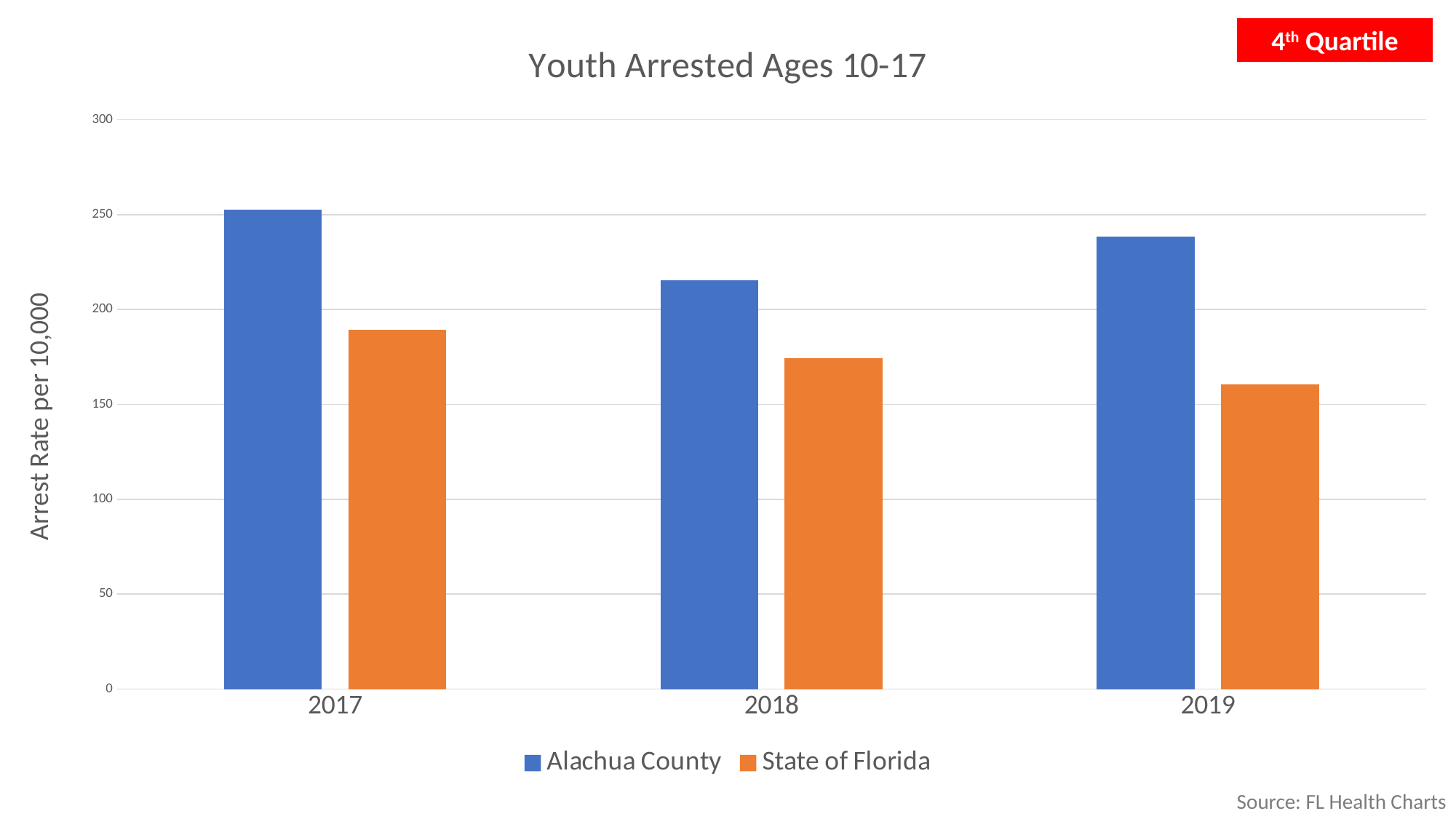
In which year is the Alachua County arrest rate highest? 2017 Is the value for State of Florida in 2019 greater or less than 150? greater How many years are shown on the x axis? 3 What is the label on the y axis of the chart? Arrest Rate per 10,000 Is the value for Alachua County in 2018 greater or less than 200? greater Which is larger in 2019, the Alachua County rate or the State of Florida rate? Alachua County Is the value for State of Florida in 2017 greater or less than 200? less What kind of chart is shown on the slide? Bar chart In which year is the State of Florida arrest rate lowest? 2019 Does the State of Florida arrest rate rise or fall from 2017 to 2019? Fall How many series does the legend list? 2 In which year is the Alachua County arrest rate lowest? 2018